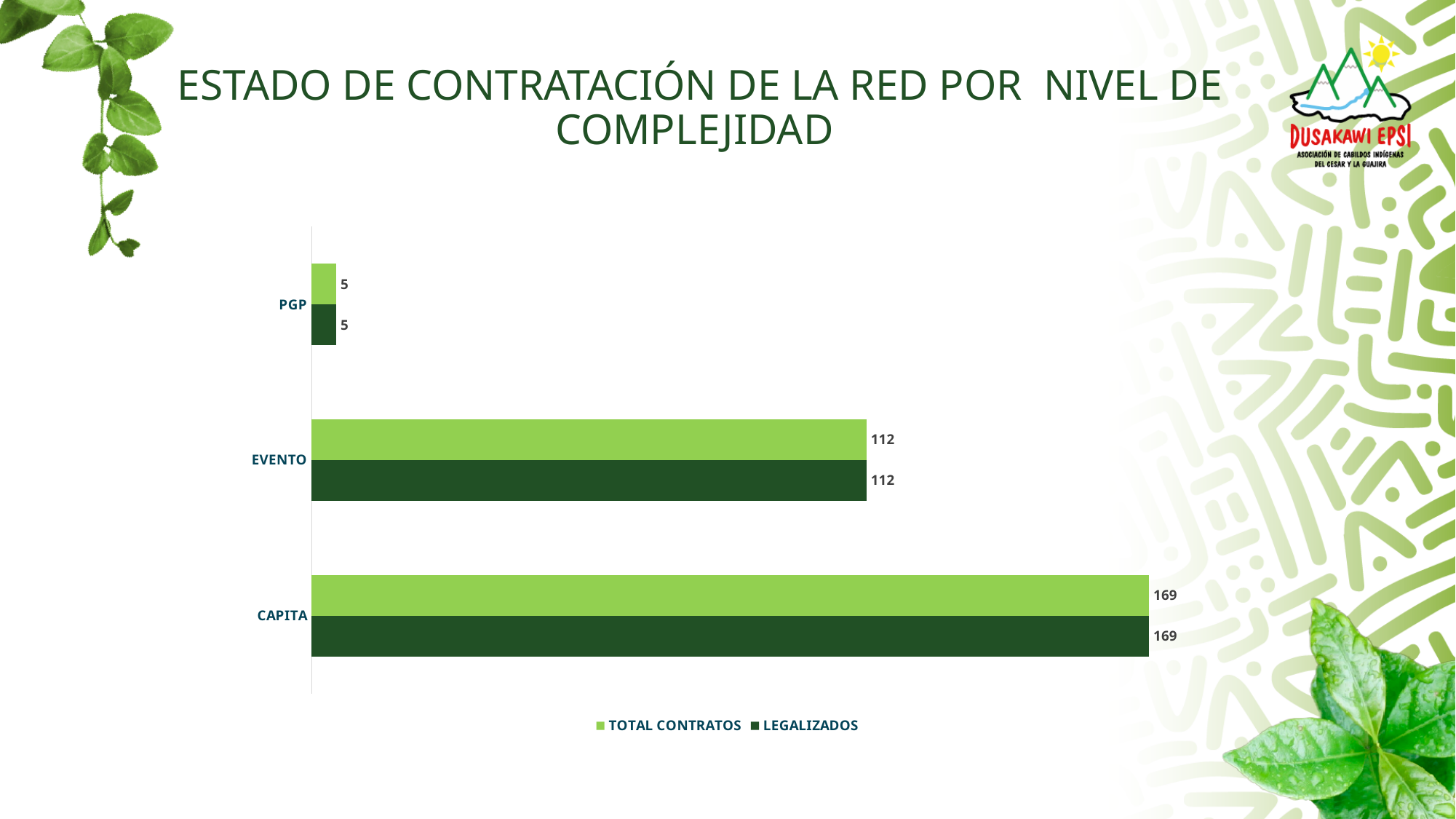
What is the difference between the TOTAL CONTRATOS values for CAPITA and EVENTO? 57 Which is larger: the TOTAL CONTRATOS value for EVENTO or for PGP? EVENTO What is the LEGALIZADOS value for EVENTO? 112 Which series is shown in dark green in the legend? LEGALIZADOS What kind of chart is shown on the slide? Bar chart What is the TOTAL CONTRATOS value for CAPITA? 169 What is the TOTAL CONTRATOS value for PGP? 5 What is the difference between the LEGALIZADOS values for EVENTO and PGP? 107 Which category has the lowest LEGALIZADOS value? PGP Which category has the highest TOTAL CONTRATOS value? CAPITA How many categories are shown on the chart? 3 How many series does the legend list? 2